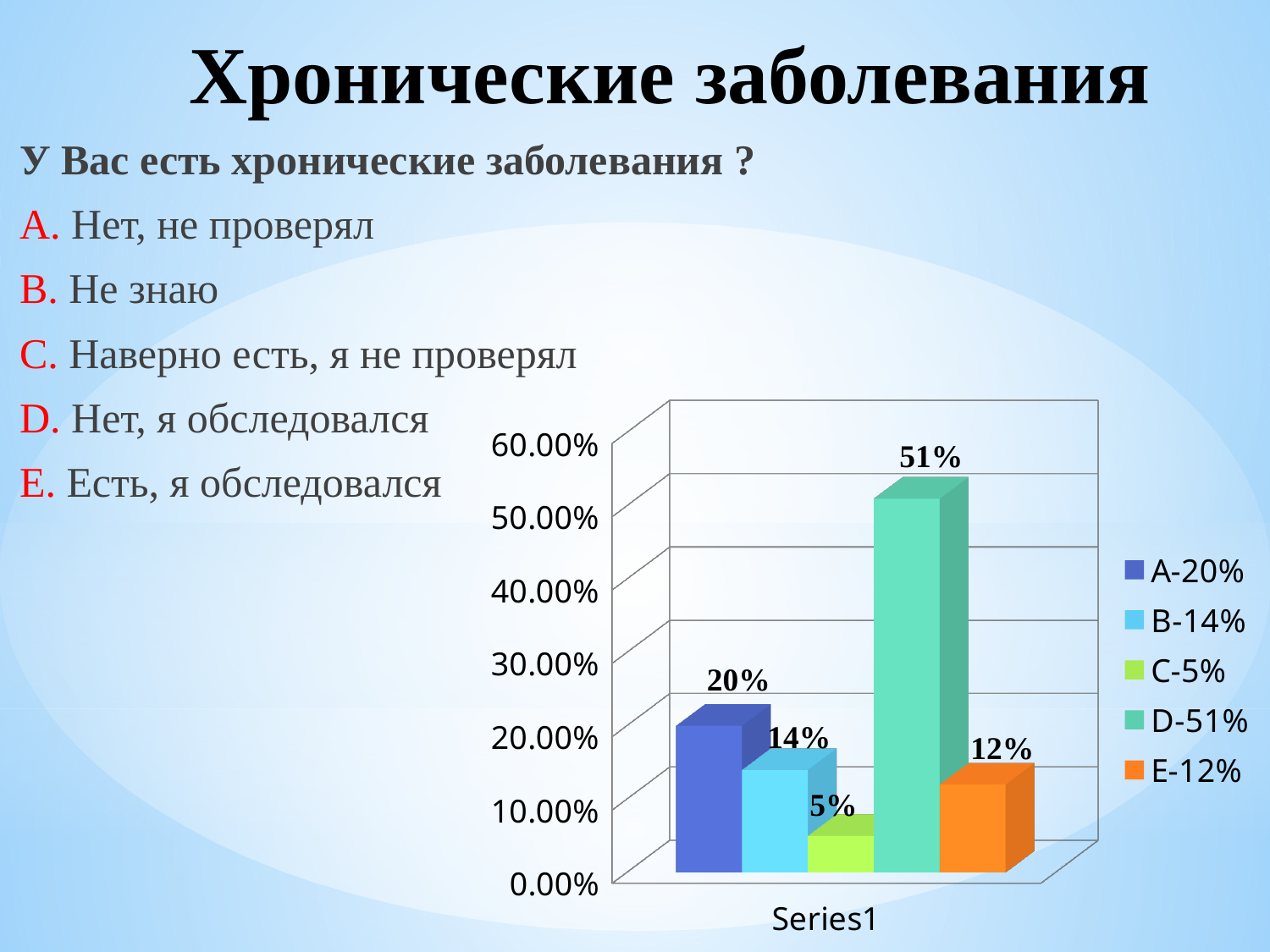
What is the difference between the values for B-14% and E-12%? 2% How many bars are plotted on the chart? 5 Which legend entry has the lowest value on the chart? C-5% What kind of chart is shown on the slide? bar chart Is the value for D-51% greater or less than 50.00%? greater Which is larger, the value for A-20% or the value for E-12%? A-20% What is the difference between the values for D-51% and A-20%? 31% What is the value shown for C-5% on the chart? 5% What is the value shown for D-51% on the chart? 51% Which legend entry has the highest value on the chart? D-51% How many entries does the chart legend list? 5 What is the value shown for A-20% on the chart? 20%